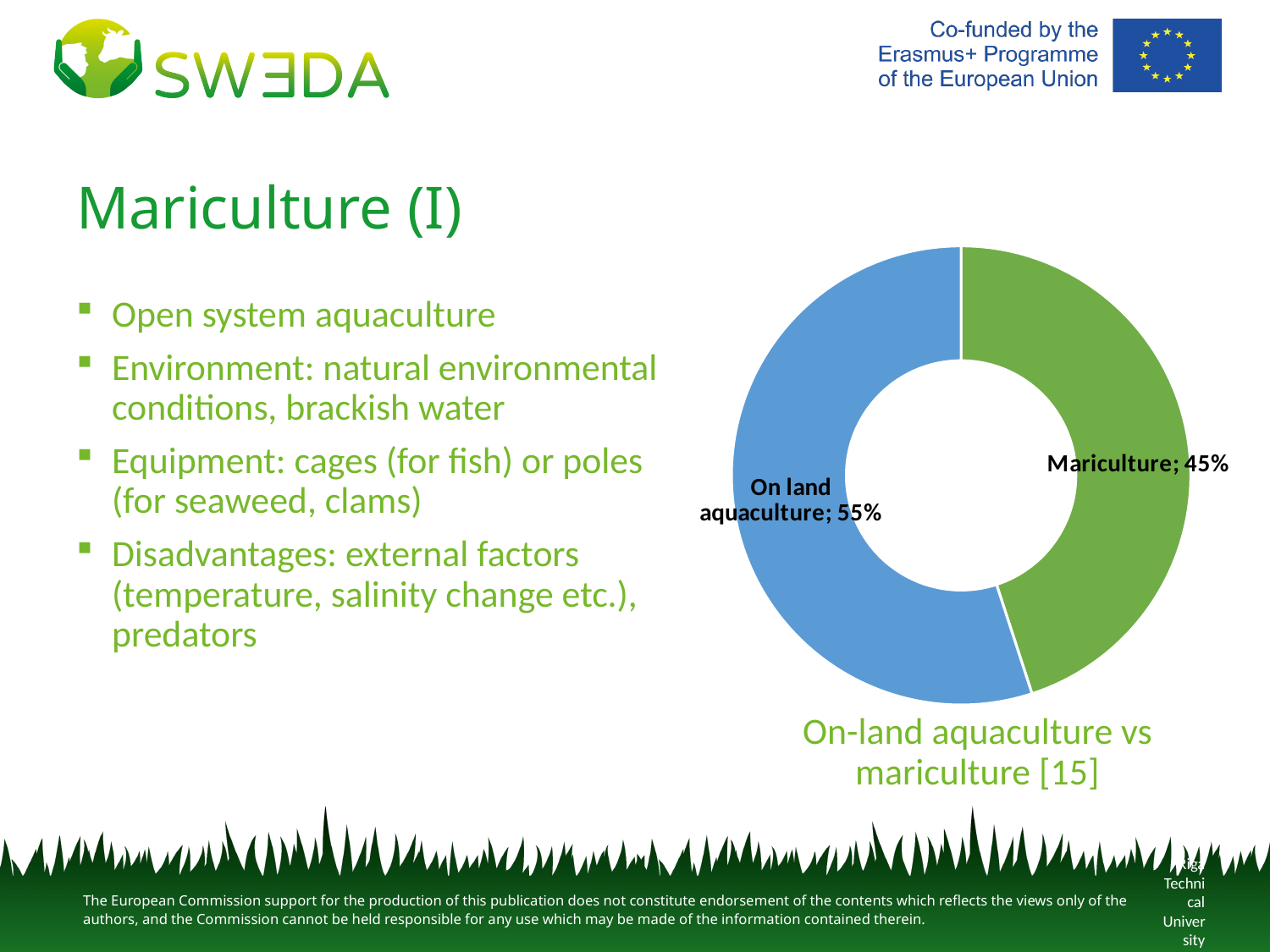
How many categories does the chart show? 2 Which category has the smallest share in the chart? Mariculture What is the value for On land aquaculture in the chart? 55% What is the caption below the chart? On-land aquaculture vs mariculture [15] What kind of chart is shown on the slide? Pie chart (doughnut) What is the value for Mariculture in the chart? 45% Is the value for Mariculture greater or less than 50%? less What is the difference between the On land aquaculture and Mariculture shares? 10% What colour is the Mariculture slice? Green Which is larger, the share for Mariculture or the share for On land aquaculture? On land aquaculture Which category has the largest share in the chart? On land aquaculture